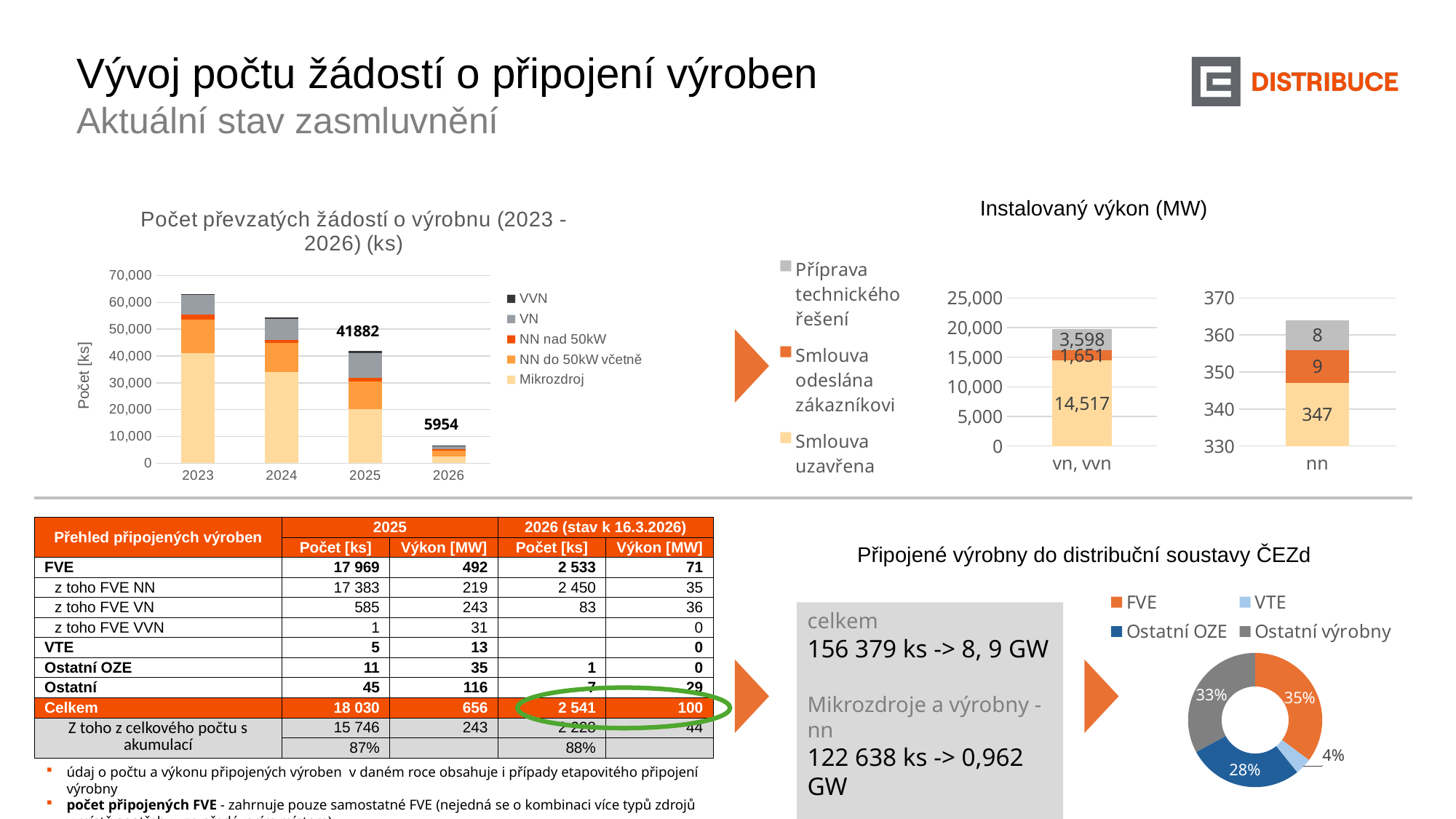
In the chart 'Počet převzatých žádostí o výrobnu (2023 - 2026) (ks)', how many series does the legend list? 5 In the chart 'Počet převzatých žádostí o výrobnu (2023 - 2026) (ks)', what is the total value labelled for 2025? 41882 In the donut chart 'Připojené výrobny do distribuční soustavy ČEZd', which category has the largest share? FVE In the 'Instalovaný výkon (MW)' chart for nn, what is the value for 'Smlouva odeslána zákazníkovi'? 9 In the chart 'Počet převzatých žádostí o výrobnu (2023 - 2026) (ks)', is the total for 2023 greater or less than 60,000? greater In the 'Instalovaný výkon (MW)' chart for vn, vvn, what is the value for 'Smlouva uzavřena'? 14,517 In the donut chart 'Připojené výrobny do distribuční soustavy ČEZd', what is the share for VTE? 4% In the donut chart 'Připojené výrobny do distribuční soustavy ČEZd', what is the difference between the shares of FVE and Ostatní OZE? 7% In the chart 'Počet převzatých žádostí o výrobnu (2023 - 2026) (ks)', do the totals rise or fall from 2023 to 2026? fall In the 'Instalovaný výkon (MW)' chart for vn, vvn, what is the value for 'Příprava technického řešení'? 3,598 In the 'Instalovaný výkon (MW)' chart for nn, what is the total of the stacked bar? 364 In the chart 'Počet převzatých žádostí o výrobnu (2023 - 2026) (ks)', what is the total value labelled for 2026? 5954